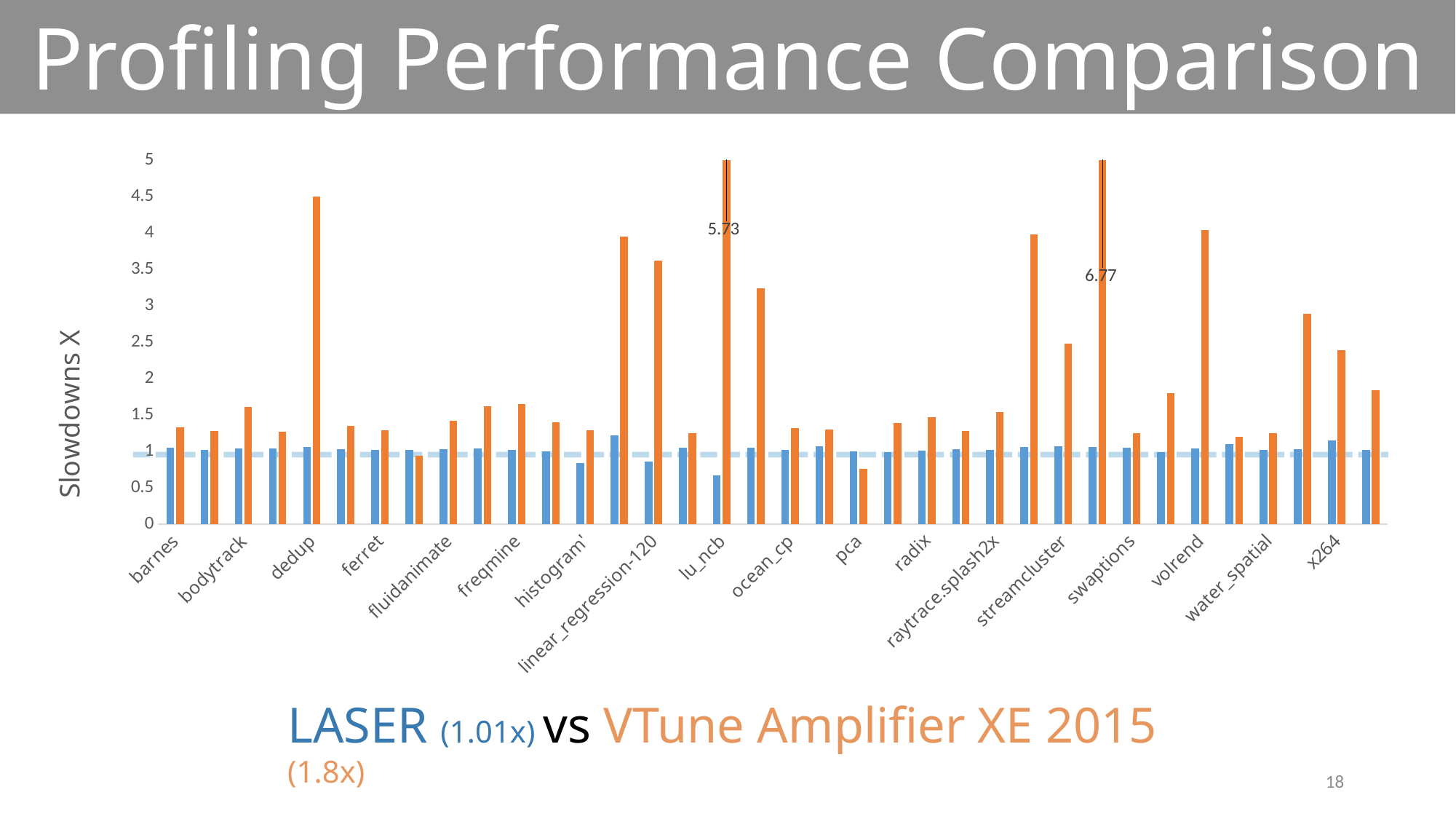
How many series does the chart compare? 2 Is the VTune Amplifier XE 2015 value for volrend greater or less than 3? greater What is the title of the y axis? Slowdowns X Is the VTune Amplifier XE 2015 value for pca greater or less than 1? less Is the LASER value for lu_ncb greater or less than 1? less What is the VTune Amplifier XE 2015 slowdown for lu_ncb? 5.73 For dedup, which is larger, the LASER value or the VTune Amplifier XE 2015 value? VTune Amplifier XE 2015 Which has the larger VTune Amplifier XE 2015 value, dedup or volrend? dedup What is the largest value printed as a data label on the chart? 6.77 What kind of chart is shown on the slide? bar chart